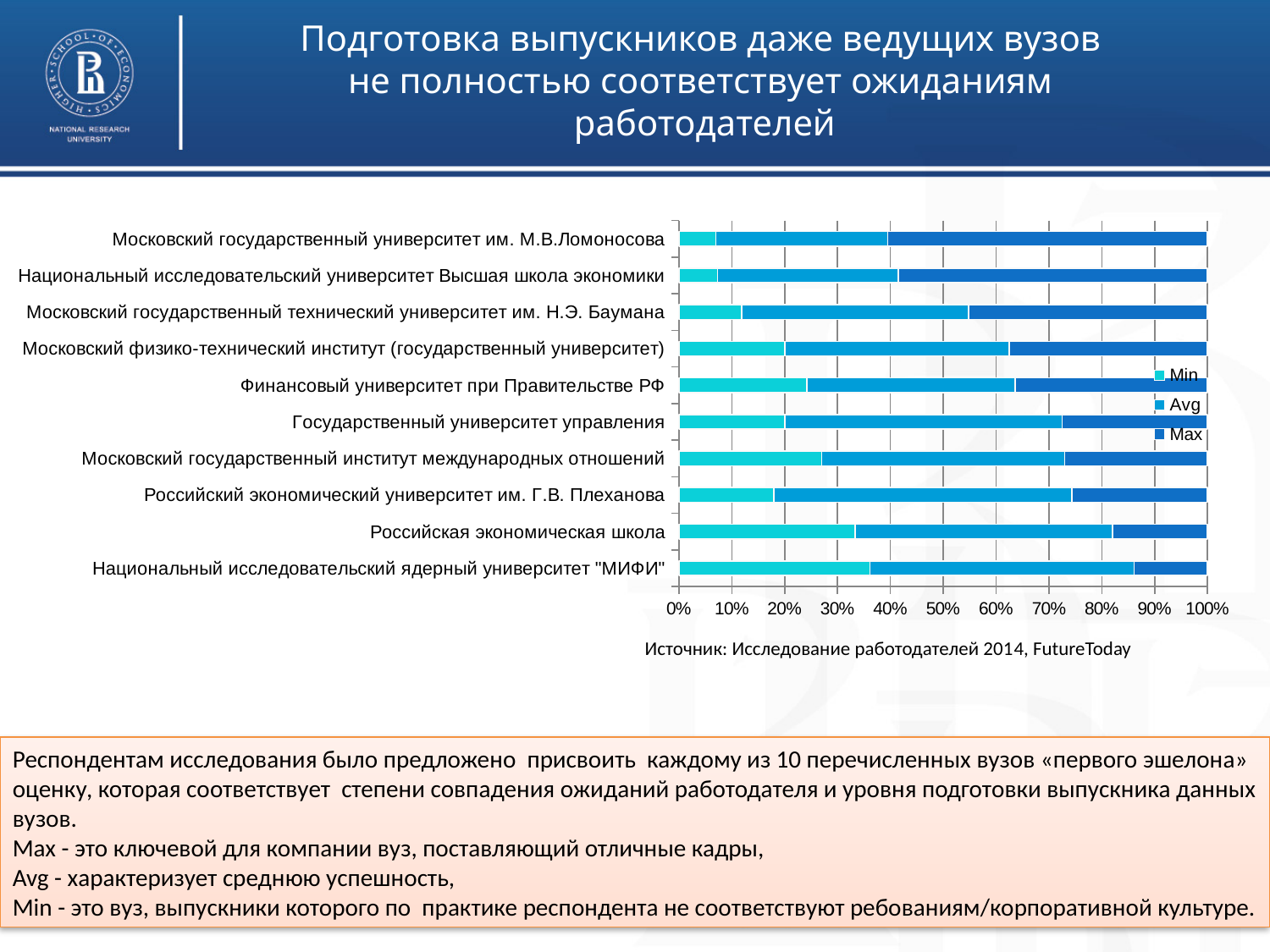
Is the Min value for Московский государственный институт международных отношений greater or less than 20%? greater How many universities are listed as categories in the chart? 10 Which has the larger Min value: Московский государственный институт международных отношений or Московский государственный университет им. М.В.Ломоносова? Московский государственный институт международных отношений Is the Min value for Национальный исследовательский ядерный университет "МИФИ" greater or less than 30%? greater Which category appears at the top of the chart? Московский государственный университет им. М.В.Ломоносова Which has the larger Min value: Финансовый университет при Правительстве РФ or Московский государственный технический университет им. Н.Э. Баумана? Финансовый университет при Правительстве РФ Is the Min value for Московский государственный университет им. М.В.Ломоносова greater or less than 10%? less What is the total of each stacked bar in the chart? 100% What kind of chart is shown on the slide? Stacked bar chart How many series does the chart legend list? 3 What are the series names shown in the chart legend? Min, Avg, Max